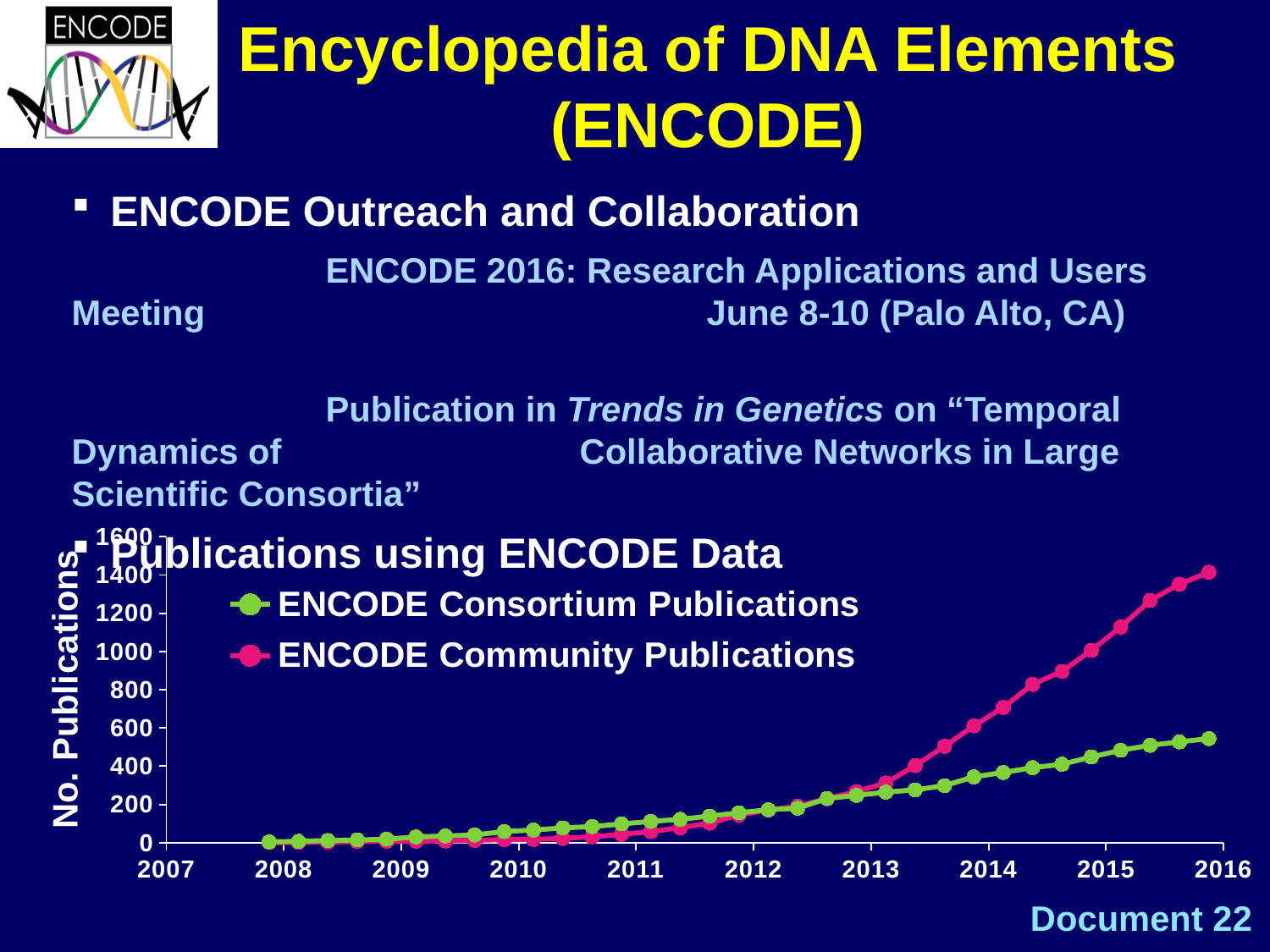
Is the final value for ENCODE Community Publications greater or less than 1200? greater Is the final value for ENCODE Consortium Publications greater or less than 800? less What kind of chart is shown on the slide? line chart Which series has the higher value at 2011? ENCODE Consortium Publications What are the two series named in the chart legend? ENCODE Consortium Publications and ENCODE Community Publications What is the label on the vertical axis of the chart? No. Publications How many series does the chart legend list? 2 Do the ENCODE Consortium Publications values rise or fall over the years shown? rise How many year labels are shown on the x axis of the chart? 10 Which series has the higher value at the end of the chart in 2016? ENCODE Community Publications Do the ENCODE Community Publications values rise or fall from 2008 to 2016? rise Is the value for ENCODE Consortium Publications at 2016 greater or less than 400? greater